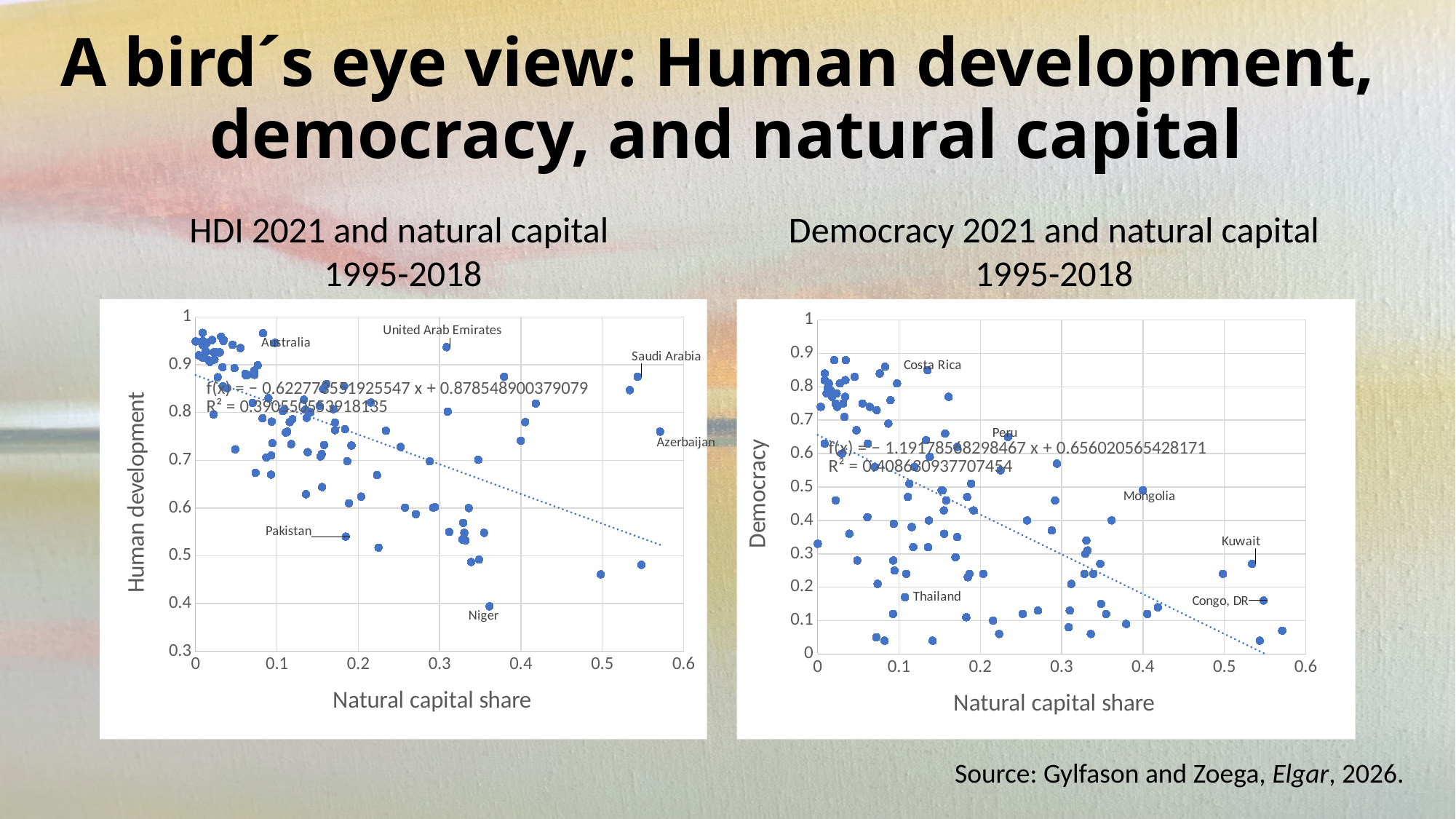
In the 'HDI 2021 and natural capital 1995-2018' chart, is the human development value for United Arab Emirates greater or less than 0.9? greater In the 'Democracy 2021 and natural capital 1995-2018' chart, which has the higher democracy value, Costa Rica or Kuwait? Costa Rica In the 'Democracy 2021 and natural capital 1995-2018' chart, is the democracy value for Thailand greater or less than 0.3? less In the 'Democracy 2021 and natural capital 1995-2018' chart, do democracy values tend to rise or fall as natural capital share increases? Fall In the 'HDI 2021 and natural capital 1995-2018' chart, which has the higher human development value, United Arab Emirates or Niger? United Arab Emirates What is the label on the x axis of the 'Democracy 2021 and natural capital 1995-2018' chart? Natural capital share In the 'Democracy 2021 and natural capital 1995-2018' chart, is the democracy value for Costa Rica greater or less than 0.8? greater In the 'HDI 2021 and natural capital 1995-2018' chart, do human development values tend to rise or fall as natural capital share increases? Fall What kind of chart is the 'HDI 2021 and natural capital 1995-2018' chart? Scatter chart